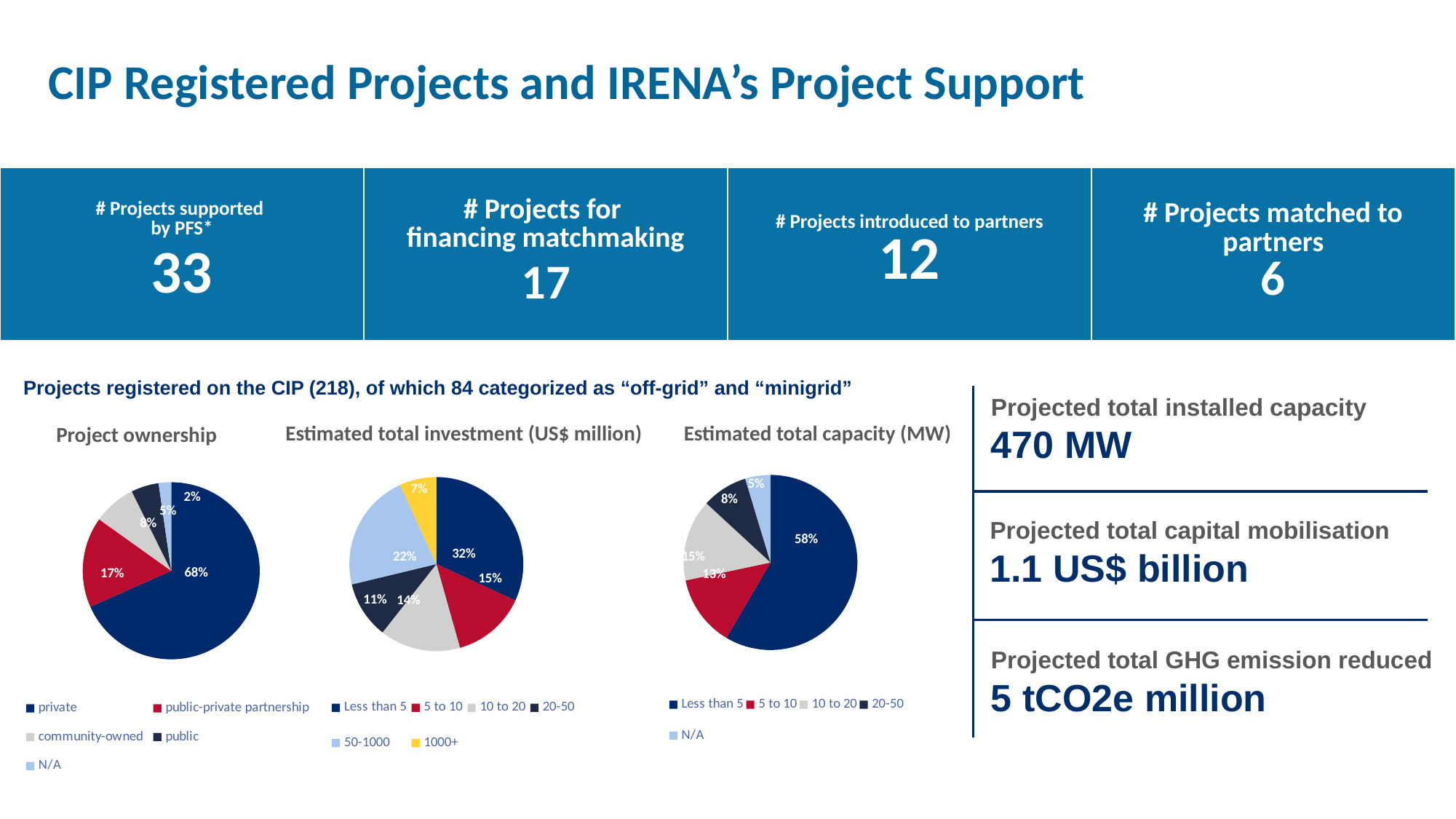
In the Estimated total capacity (MW) chart, what share is in the 20-50 category? 8% In the Estimated total investment (US$ million) chart, what is the difference between the Less than 5 share and the 1000+ share? 25% In the Estimated total investment (US$ million) chart, what share is in the 50-1000 category? 22% In the Project ownership chart, what share of projects is public-private partnership? 17% In the Estimated total investment (US$ million) chart, which is larger: the 5 to 10 share or the 20-50 share? 5 to 10 In the Estimated total capacity (MW) chart, what share is in the Less than 5 category? 58% In the Estimated total capacity (MW) chart, which category has the smallest share? N/A In the Project ownership chart, what share of projects is private? 68% In the Project ownership chart, which category has the smallest share? N/A In the Estimated total investment (US$ million) chart, which category has the largest share? Less than 5 In the Project ownership chart, how many categories does the legend list? 5 What type of chart is used for Project ownership? Pie chart